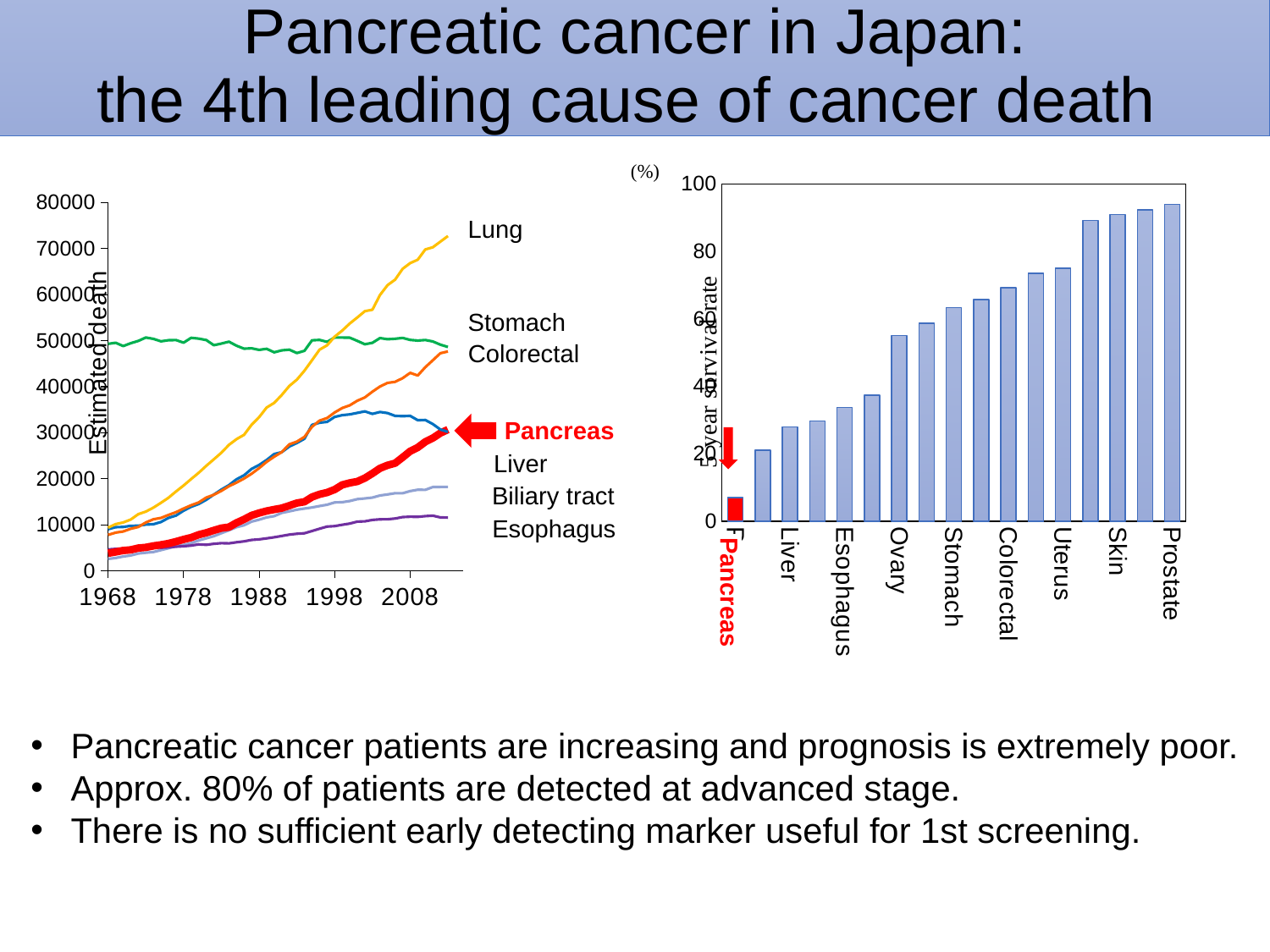
In the bar chart on the right, is the 5-year survival rate for Prostate greater or less than 80? greater What kind of chart is the chart on the left of the slide? line chart In the bar chart on the right, is the 5-year survival rate for Pancreas greater or less than 20? less In the bar chart on the right, is the 5-year survival rate for Uterus greater or less than 80? less In the line chart on the left, which cancer has the highest estimated deaths at the end of the period? Lung What kind of chart is the chart on the right of the slide? bar chart In the bar chart on the right, which labeled cancer type has the lowest 5-year survival rate? Pancreas In the line chart on the left, which series is drawn as a thick red line? Pancreas In the bar chart on the right, which labeled cancer type has the highest 5-year survival rate? Prostate In the bar chart on the right, do the bars rise or fall from left to right? rise In the line chart on the left, does the Lung line rise or fall from 1968 to the end of the period? rise